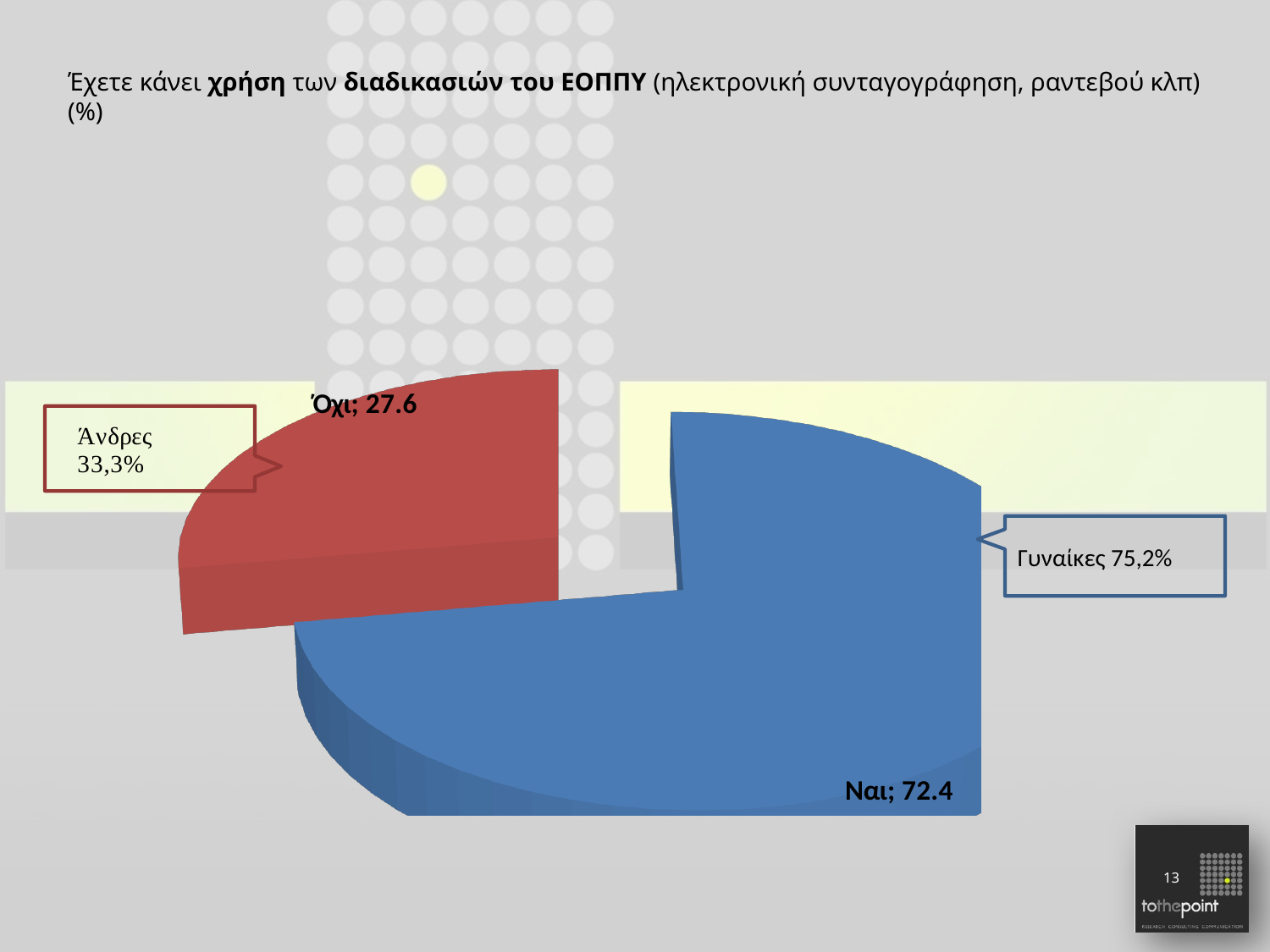
Which slice of the pie is the smallest? Όχι What is the value shown for the "Όχι" slice? 27.6 What type of chart is shown on the slide? Pie chart How many slices does the pie chart have? 2 Which is larger, the "Ναι" slice or the "Όχι" slice? Ναι What percentage is shown in the callout labelled "Άνδρες"? 33,3% Which slice of the pie is the largest? Ναι What is the difference between the "Ναι" and "Όχι" values? 44.8 What is the value shown for the "Ναι" slice? 72.4 What colour is the "Όχι" slice of the pie? Red What percentage is shown in the callout labelled "Γυναίκες"? 75,2% What colour is the "Ναι" slice of the pie? Blue